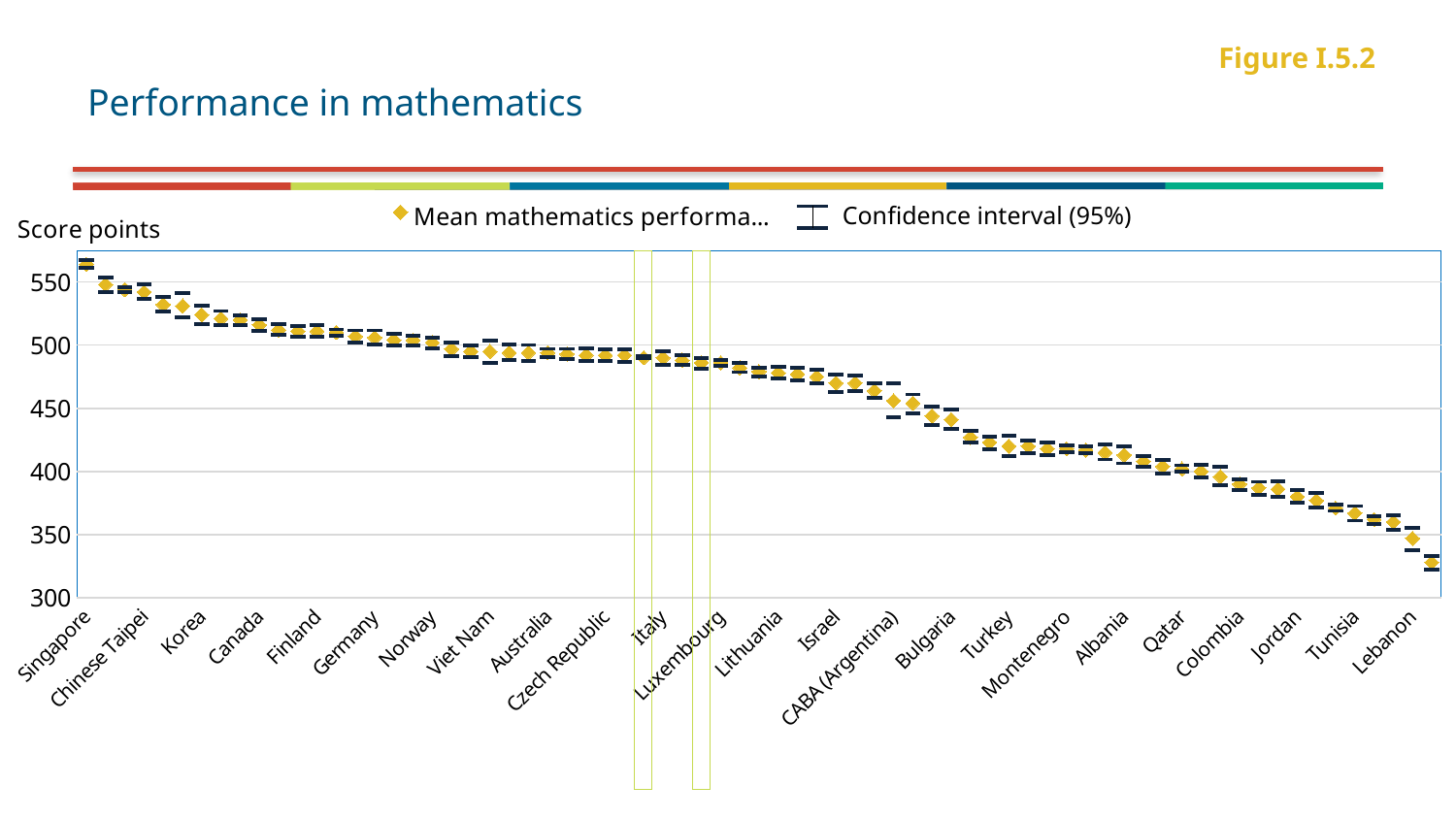
Which country has the highest mean mathematics performance? Singapore Is the mean mathematics score for Korea greater or less than 500? greater Do the mean mathematics scores rise or fall from left to right along the x axis? fall Which has the higher mean mathematics score, Korea or Turkey? Korea What is the title of the chart? Performance in mathematics Is the mean mathematics score for Bulgaria greater or less than 450? less What label is shown on the vertical axis of the chart? Score points Is the mean mathematics score for Jordan greater or less than 400? less How many entries does the chart legend list? 2